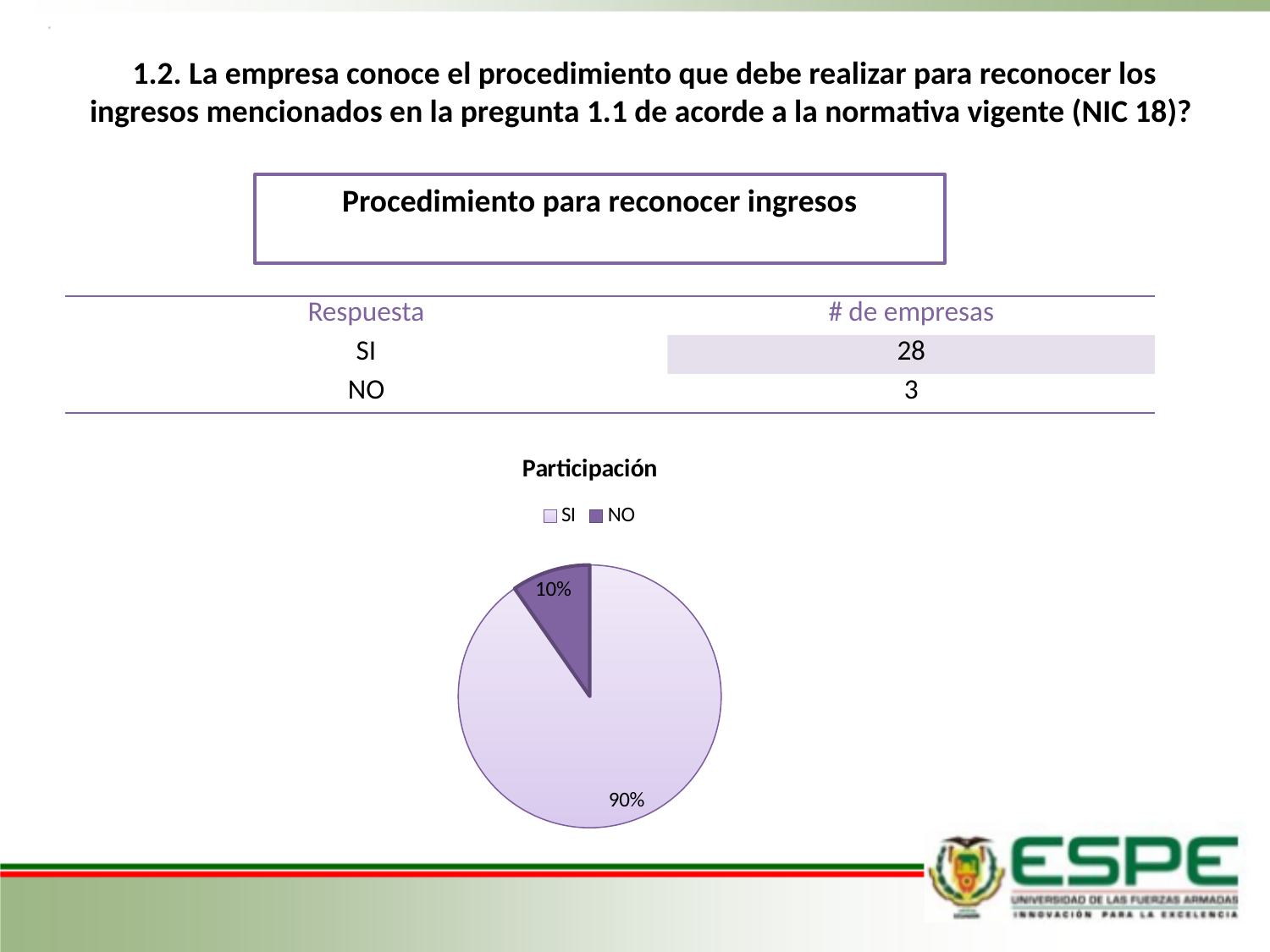
Which slice of the pie is the smallest? NO What is the difference in percentage points between the SI and NO slices? 80 percentage points How many slices does the pie chart have? 2 Which legend entry is shown in the darker purple colour? NO Which slice is larger, SI or NO? SI What is the title of the chart? Participación What share of the pie does the NO slice represent? 10% Is the share of the SI slice greater or less than 50%? greater What share of the pie does the SI slice represent? 90% How many entries does the legend of the chart list? 2 Which slice of the pie is the largest? SI What type of chart is shown on the slide? pie chart